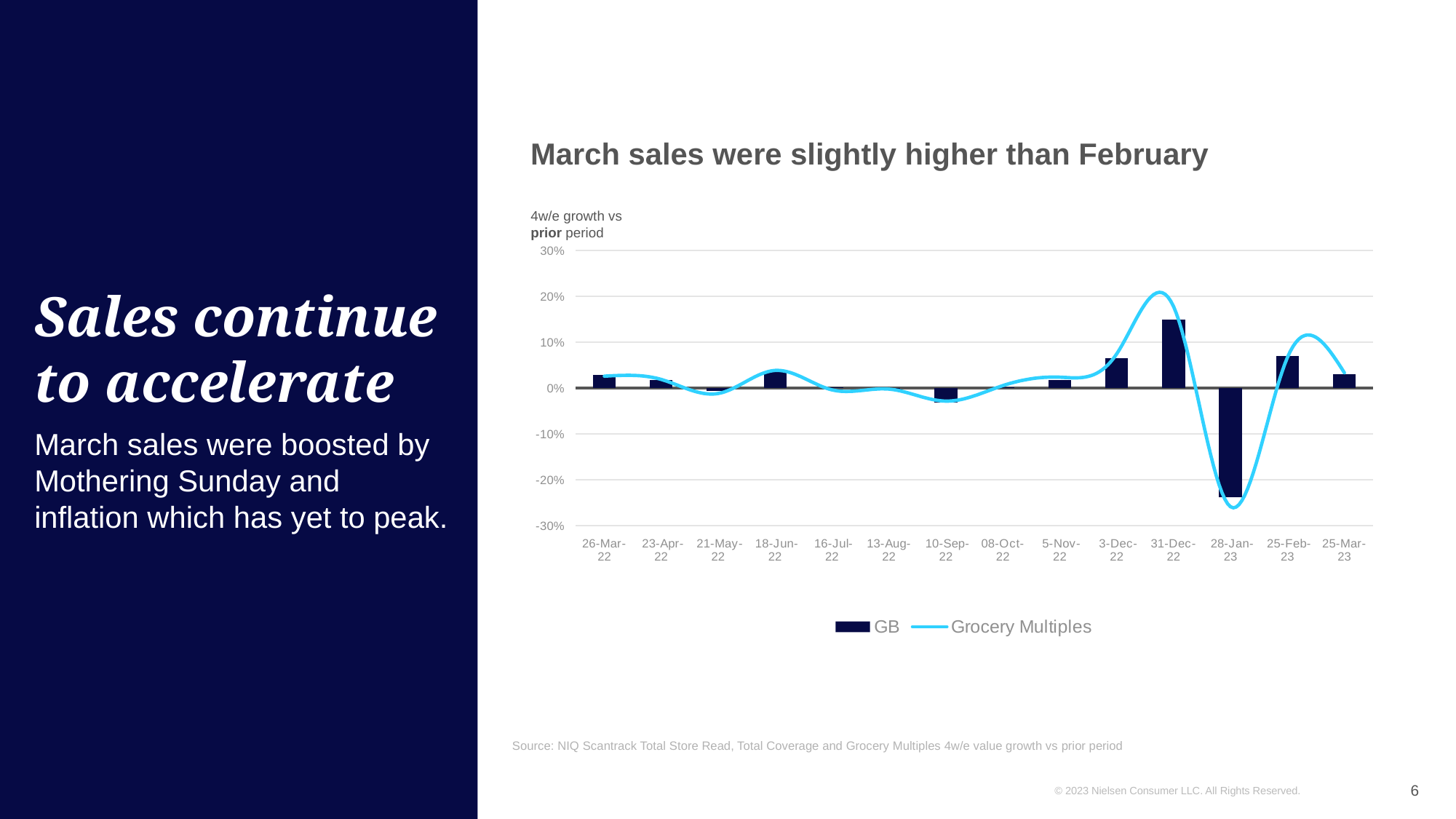
Is the GB value for 28-Jan-23 greater or less than -20%? less What is the title of the chart? March sales were slightly higher than February In which period is the GB bar highest? 31-Dec-22 Is the GB value for 31-Dec-22 greater or less than 10%? greater What kind of chart is shown on the slide? A combined bar and line chart In which period is the GB bar lowest? 28-Jan-23 What are the two series named in the legend? GB and Grocery Multiples Which has the larger GB value, 25-Feb-23 or 25-Mar-23? 25-Feb-23 How many dated periods are shown along the x axis? 14 Does the GB value rise or fall from 31-Dec-22 to 28-Jan-23? fall Is the GB value for 3-Dec-22 greater or less than 10%? less How many series does the legend list? 2